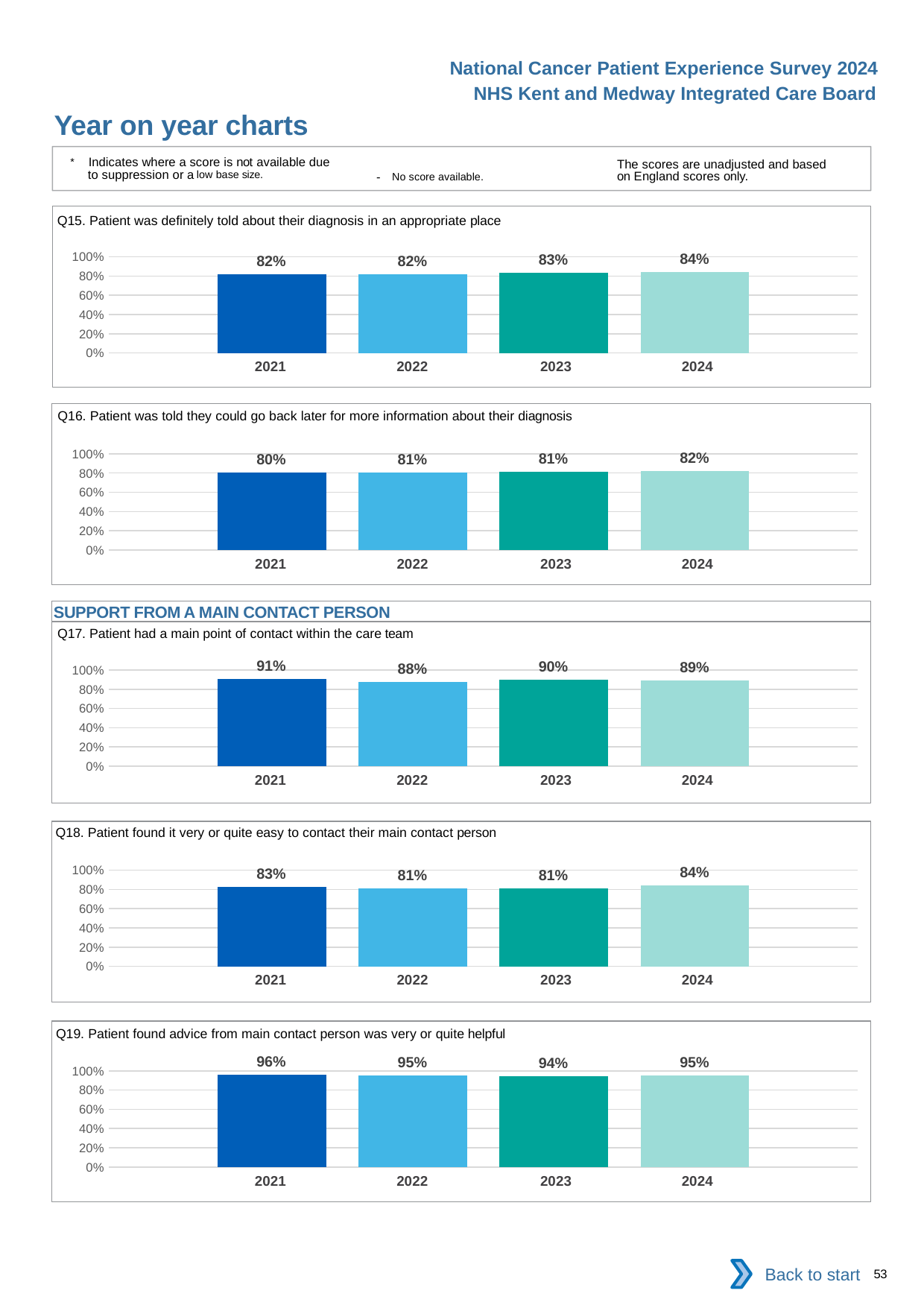
In the Q19 chart (Patient found advice from main contact person was very or quite helpful), what is the value for 2021? 96% In the Q16 chart (Patient was told they could go back later for more information about their diagnosis), do the values rise or fall from 2021 to 2024? rise In the Q18 chart (Patient found it very or quite easy to contact their main contact person), what is the difference between the 2024 value and the 2023 value? 3% In the Q19 chart (Patient found advice from main contact person was very or quite helpful), which year has the lowest value? 2023 What kind of chart is the Q18 chart (Patient found it very or quite easy to contact their main contact person)? bar chart How many years are shown on the x axis of the Q16 chart (Patient was told they could go back later for more information about their diagnosis)? 4 In the Q16 chart (Patient was told they could go back later for more information about their diagnosis), what is the value for 2021? 80% In the Q15 chart (Patient was definitely told about their diagnosis in an appropriate place), is the value for 2021 larger or smaller than the value for 2024? smaller In the Q15 chart (Patient was definitely told about their diagnosis in an appropriate place), what is the value for 2024? 84% In the Q17 chart (Patient had a main point of contact within the care team), which year has the highest value? 2021 In the Q17 chart (Patient had a main point of contact within the care team), which year has the lowest value? 2022 What is the section heading shown above the Q17 chart? SUPPORT FROM A MAIN CONTACT PERSON